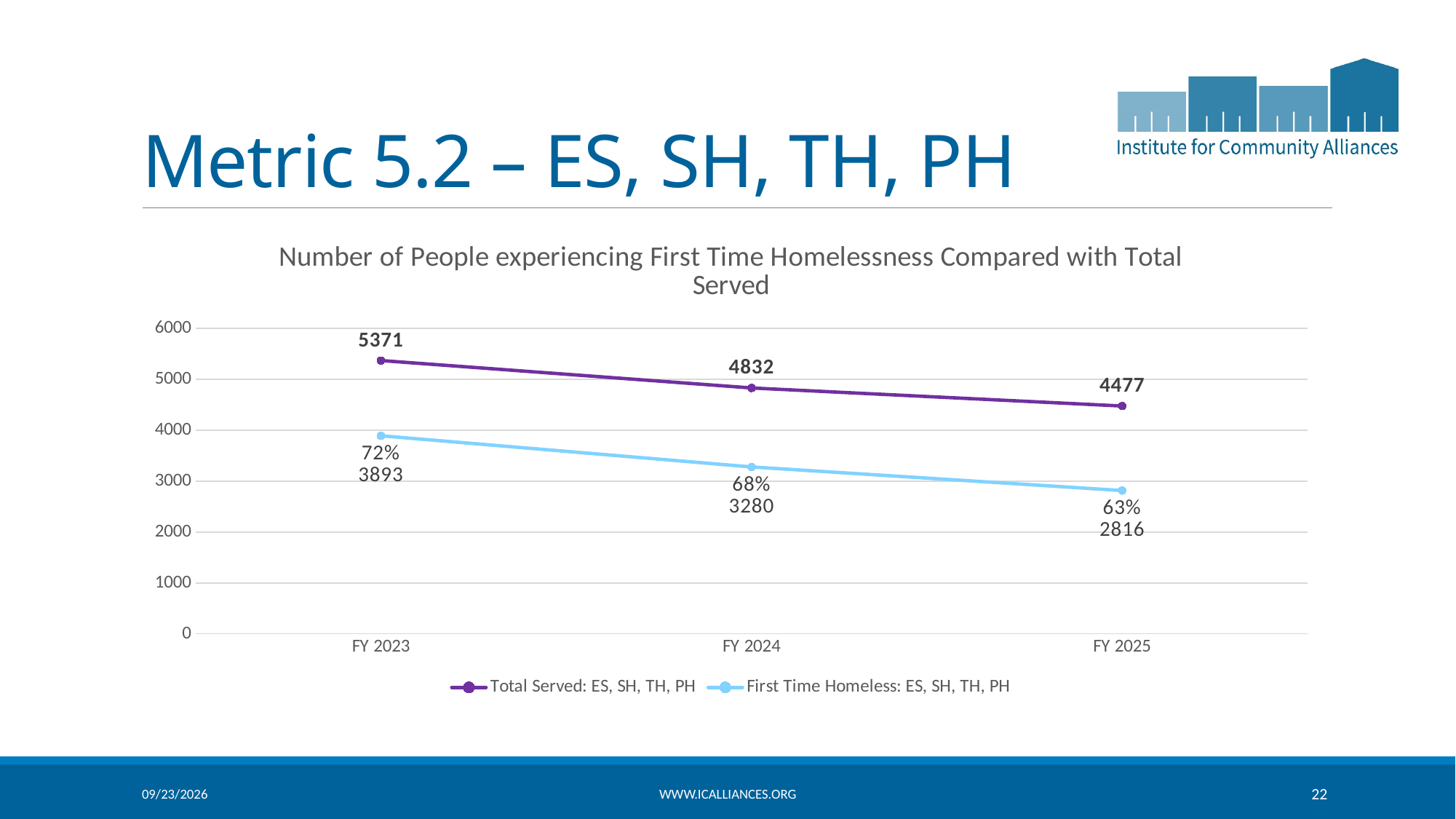
What is the difference between Total Served and First Time Homeless in FY 2024? 1552 Which is larger in FY 2025: Total Served or First Time Homeless? Total Served In which fiscal year is First Time Homeless: ES, SH, TH, PH highest? FY 2023 By how much did Total Served: ES, SH, TH, PH decrease from FY 2023 to FY 2025? 894 What percentage is shown for First Time Homeless: ES, SH, TH, PH in FY 2024? 68% In which fiscal year is Total Served: ES, SH, TH, PH lowest? FY 2025 What is the value for Total Served: ES, SH, TH, PH in FY 2023? 5371 Is the value for First Time Homeless: ES, SH, TH, PH in FY 2025 greater or less than 3000? less How many series does the legend list? 2 How many fiscal years are plotted on the x axis? 3 What is the value for First Time Homeless: ES, SH, TH, PH in FY 2025? 2816 What kind of chart is shown on the slide? line chart